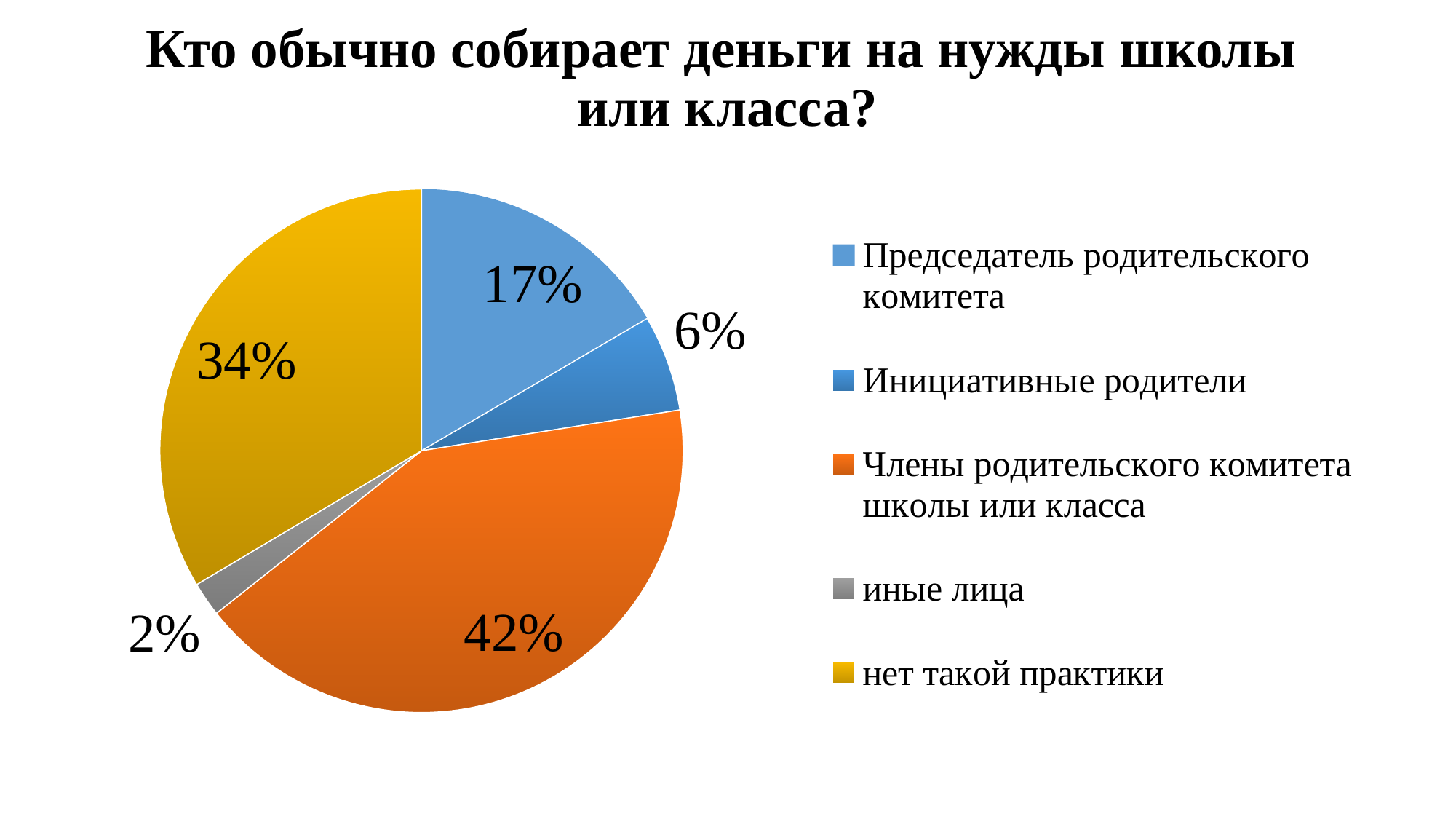
What is the title of the chart? Кто обычно собирает деньги на нужды школы или класса? Which category has the largest slice? Члены родительского комитета школы или класса What share of the pie does "Члены родительского комитета школы или класса" have? 42% What is the difference between "Члены родительского комитета школы или класса" and "нет такой практики"? 8% How many categories does the pie chart show? 5 What is the value for "иные лица"? 2% What kind of chart is shown on the slide? Pie chart What is the value for "Инициативные родители"? 6% Which is larger, "Председатель родительского комитета" or "Инициативные родители"? Председатель родительского комитета What is the value for "Председатель родительского комитета"? 17% What is the value for "нет такой практики"? 34% Which category has the smallest slice? иные лица